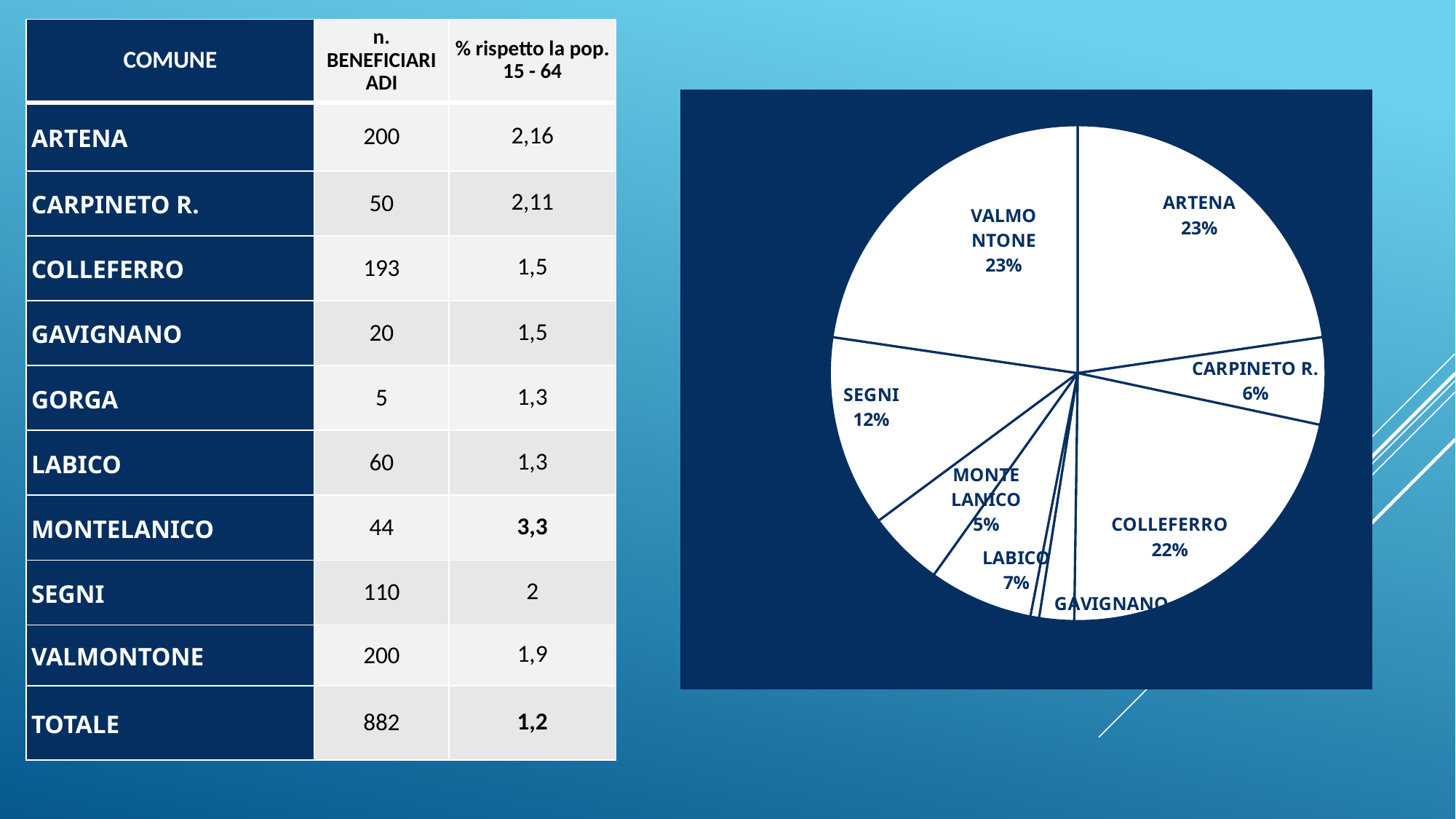
What colour are the slices of the pie chart? white In the pie chart, which slice is larger, SEGNI or LABICO? SEGNI In the pie chart, what share is shown for COLLEFERRO? 22% In the pie chart, what share is shown for LABICO? 7% In the pie chart, what share is shown for MONTELANICO? 5% In the pie chart, which slice is larger, COLLEFERRO or CARPINETO R.? COLLEFERRO In the pie chart, what is the difference in percentage points between the ARTENA share and the CARPINETO R. share? 17 In the pie chart, what share is shown for CARPINETO R.? 6% In the pie chart, what share is shown for ARTENA? 23% In the pie chart, what share is shown for VALMONTONE? 23% In the pie chart, what share is shown for SEGNI? 12% What kind of chart is shown on the right side of the slide? pie chart